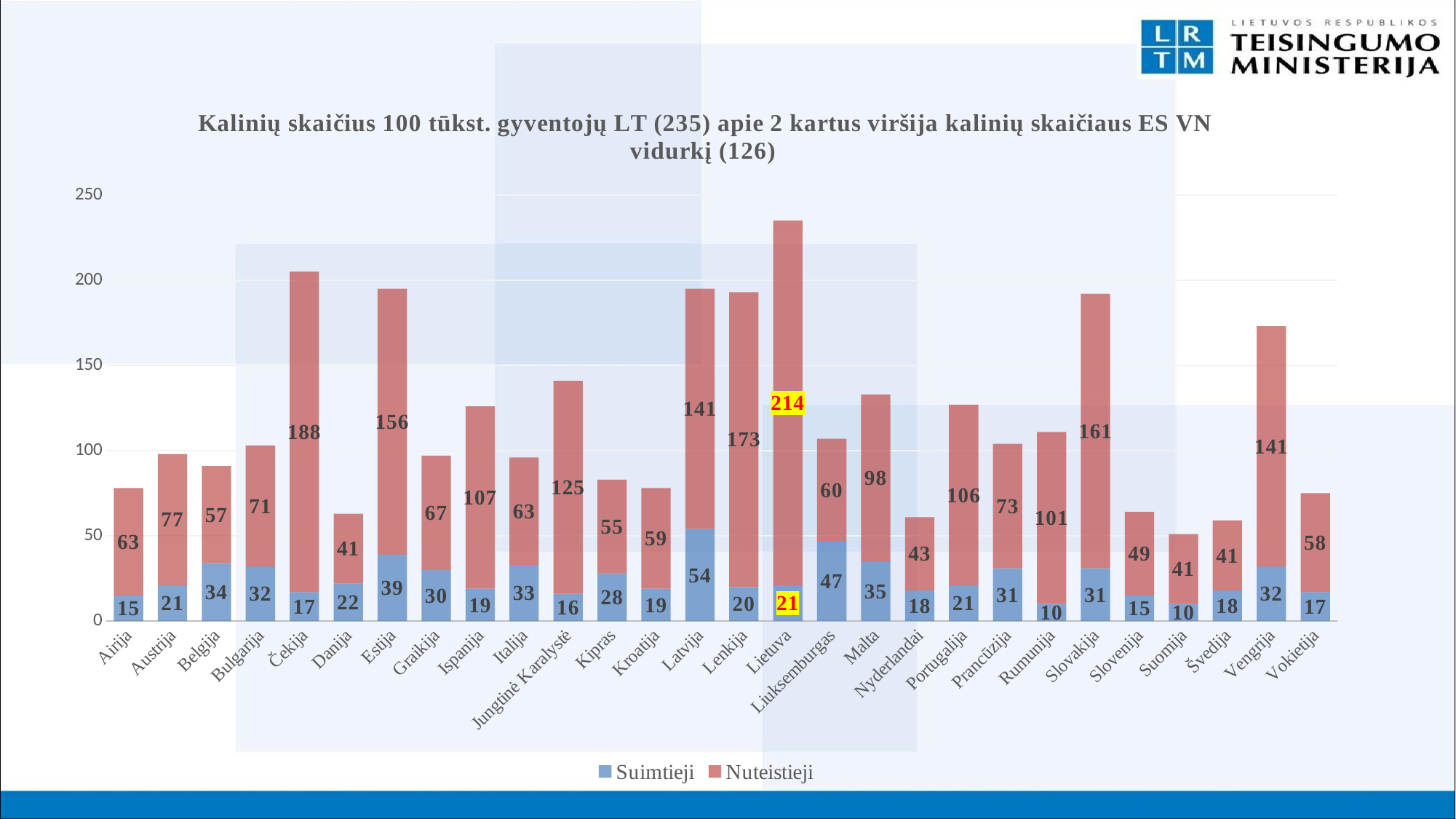
What is the total of the stacked bar for Lietuva? 235 What is the total of the stacked bar for Čekija? 205 What is the difference between the Nuteistieji values for Čekija and Estija? 32 Which country has the highest Suimtieji value? Latvija What are the two legend entries of the chart? Suimtieji and Nuteistieji What kind of chart is shown on the slide? Stacked bar chart Which country has the highest Nuteistieji value? Lietuva What is the Suimtieji value for Latvija? 54 What is the Nuteistieji value for Čekija? 188 How many series does the legend list? 2 How many countries are shown on the x axis? 28 Which has a larger Nuteistieji value, Lenkija or Slovakija? Lenkija